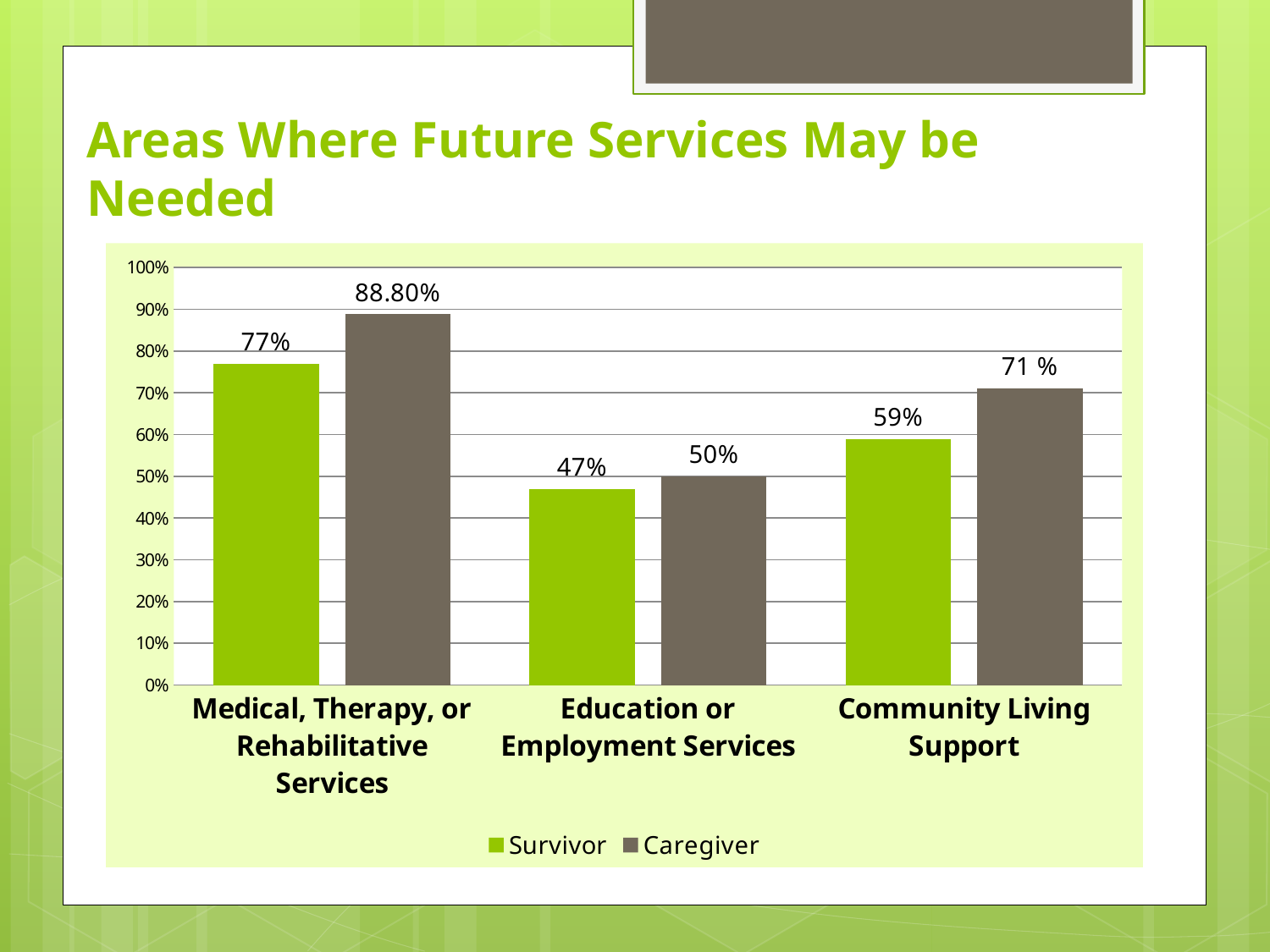
How many series does the legend list? 2 Which is larger for Education or Employment Services, the Survivor value or the Caregiver value? Caregiver Which category has the lowest Caregiver value? Education or Employment Services What is the Survivor value for Education or Employment Services? 47% What kind of chart is shown on the slide? Bar chart How many categories are shown on the x axis? 3 What is the difference between the Caregiver and Survivor values for Community Living Support? 12% Which category has the highest Survivor value? Medical, Therapy, or Rehabilitative Services Is the Survivor value for Community Living Support greater or less than 50%? greater What is the Survivor value for Medical, Therapy, or Rehabilitative Services? 77% What is the Caregiver value for Medical, Therapy, or Rehabilitative Services? 88.80% What is the Caregiver value for Community Living Support? 71 %